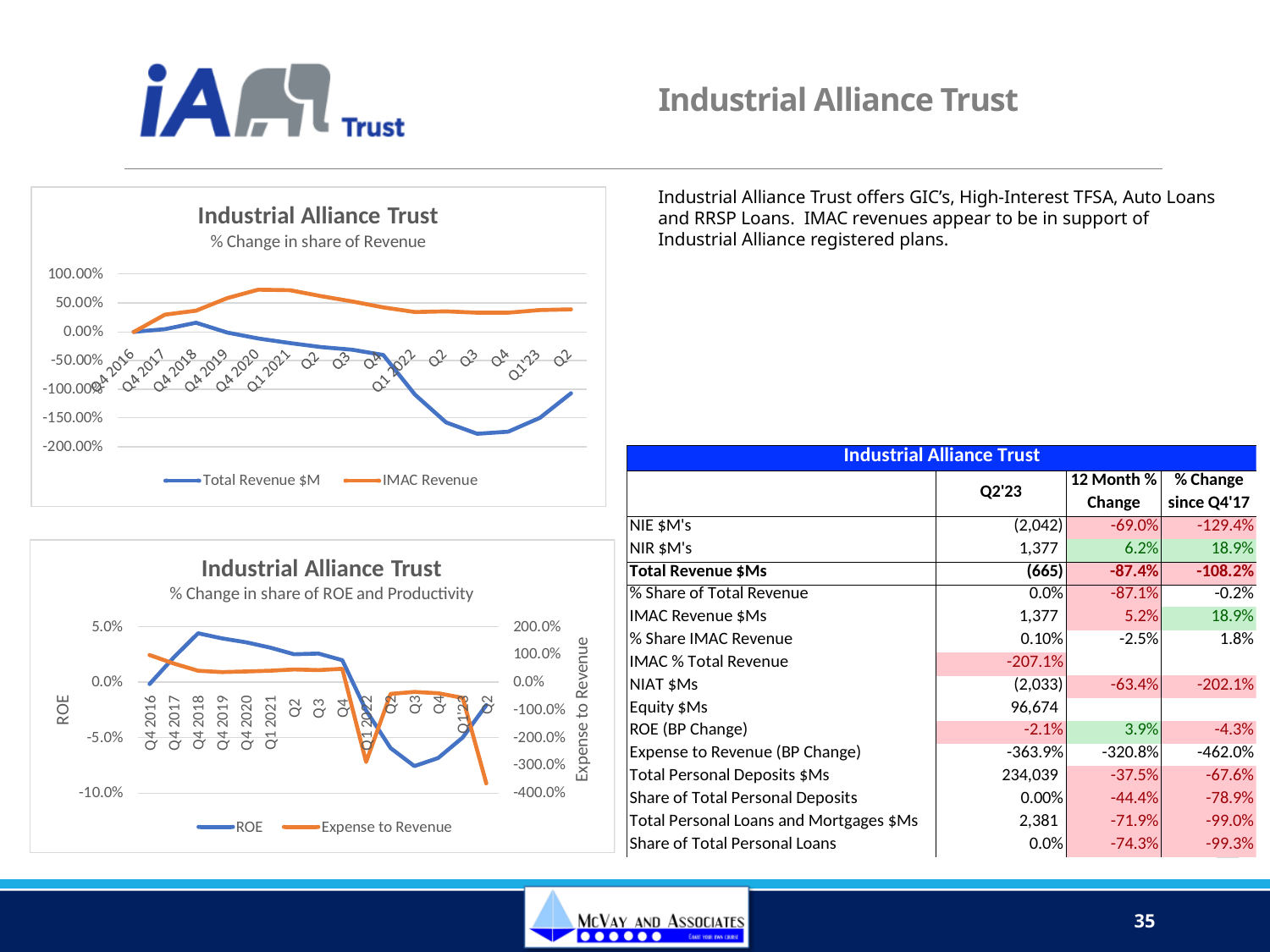
In the top chart (% Change in share of Revenue), does the IMAC Revenue line rise or fall from Q4 2016 to Q1 2021? Rise In the top chart (% Change in share of Revenue), is the value for IMAC Revenue at Q1 2021 greater or less than 50.00%? greater How many series does the legend of the top chart (% Change in share of Revenue) list? 2 In the bottom chart (% Change in share of ROE and Productivity), at which quarter is the ROE line lowest? Q3 2022 In the top chart (% Change in share of Revenue), which series has the higher value at the final point, Q2 (2023): Total Revenue $M or IMAC Revenue? IMAC Revenue In the top chart (% Change in share of Revenue), does the Total Revenue $M line rise or fall from Q4 2018 to Q3 2022? Fall In the top chart (% Change in share of Revenue), is the value for Total Revenue $M at Q3 2022 greater or less than -150.00%? less In the bottom chart (% Change in share of ROE and Productivity), is the Expense to Revenue value at the final point, Q2 (2023), greater or less than -300.0%? less What kind of chart is the top chart titled 'Industrial Alliance Trust % Change in share of Revenue'? Line chart In the bottom chart (% Change in share of ROE and Productivity), at which quarter is the ROE line highest? Q4 2018 What are the two series named in the legend of the bottom chart (% Change in share of ROE and Productivity)? ROE and Expense to Revenue